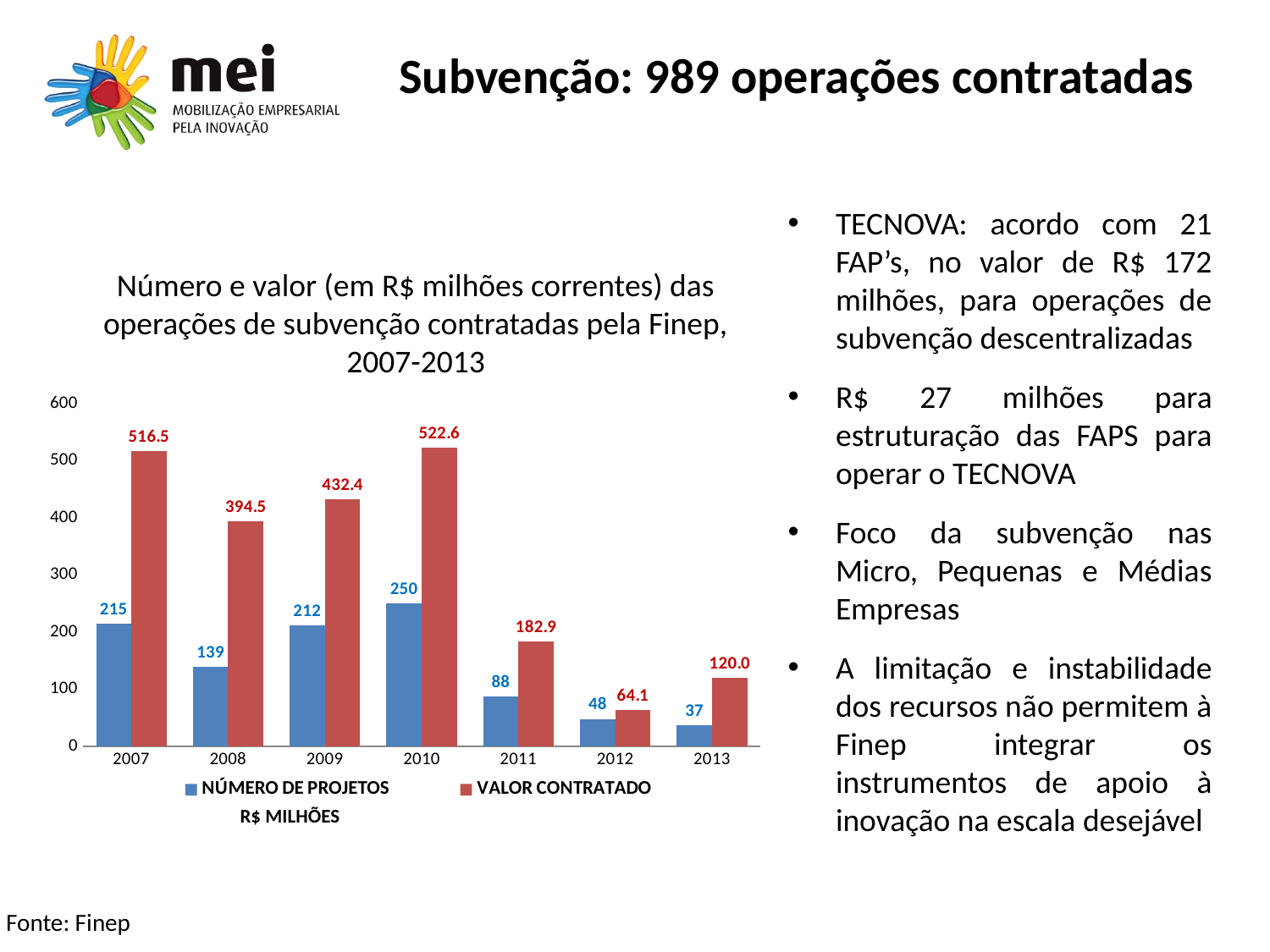
Which year has the lowest NÚMERO DE PROJETOS? 2013 What kind of chart is shown on the slide? bar chart How many series does the chart legend list? 2 What is the difference in NÚMERO DE PROJETOS between 2007 and 2009? 3 What is the VALOR CONTRATADO for 2008? 394.5 What is the VALOR CONTRATADO for 2013? 120.0 Which is larger, the NÚMERO DE PROJETOS for 2008 or for 2011? 2008 What is the difference between the VALOR CONTRATADO for 2010 and 2007? 6.1 Which year has the highest VALOR CONTRATADO? 2010 How many years are shown on the x axis of the chart? 7 What is the value of NÚMERO DE PROJETOS for 2010? 250 Does the VALOR CONTRATADO rise or fall from 2010 to 2012? fall